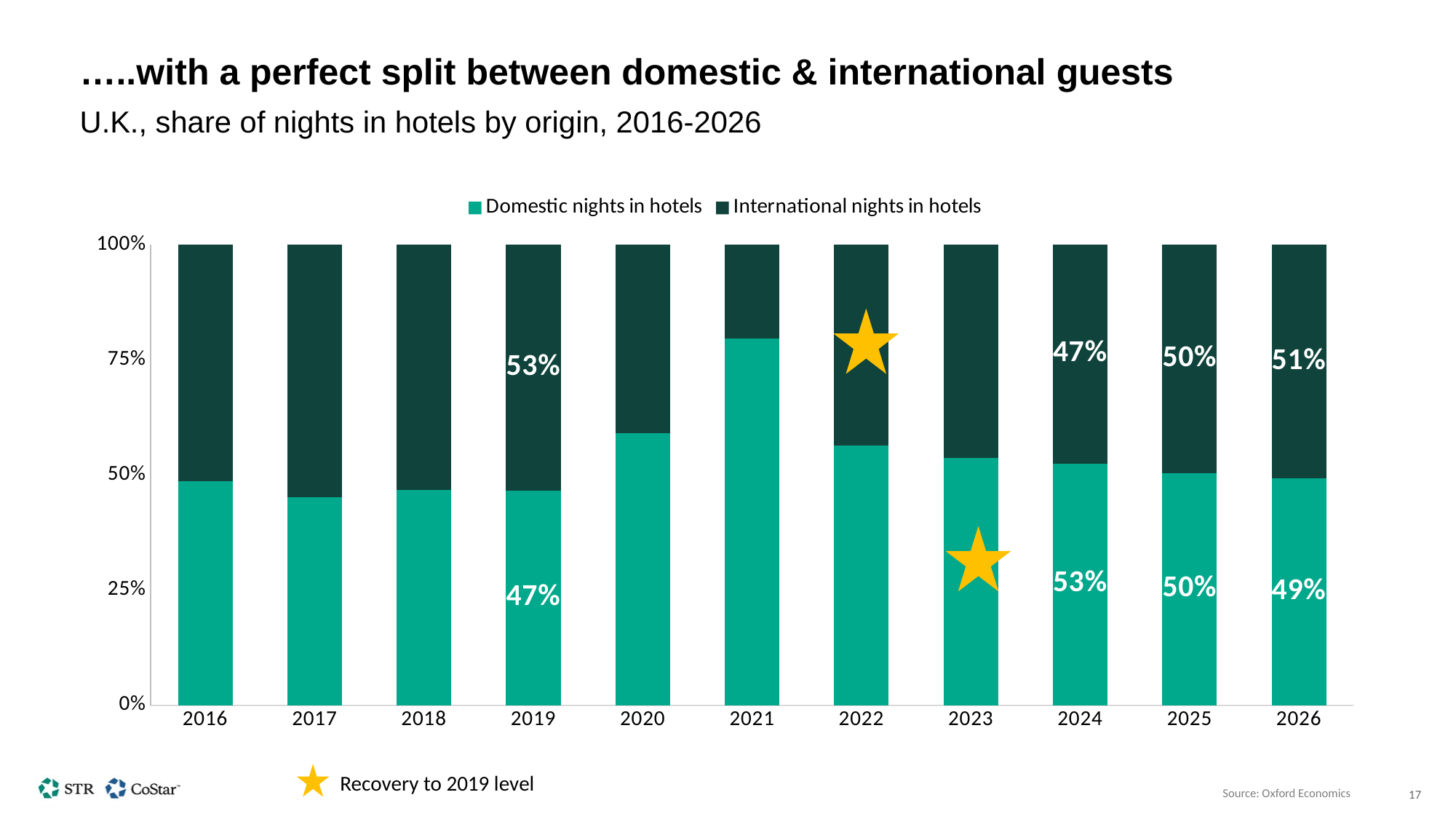
What is the share of domestic nights in hotels in 2026? 49% Is the share of domestic nights in hotels in 2021 greater or less than 75%? greater What is the difference between the international and domestic shares of nights in hotels in 2019? 6 percentage points What is the share of international nights in hotels in 2025? 50% How many years are shown on the x axis? 11 What is the share of domestic nights in hotels in 2019? 47% Is the share of domestic nights in hotels in 2016 greater or less than 50%? less Which year has the highest share of domestic nights in hotels? 2021 Which year has a larger share of domestic nights in hotels, 2020 or 2017? 2020 How many series does the legend list? 2 What type of chart is shown on the slide? Stacked bar chart What is the share of international nights in hotels in 2024? 47%